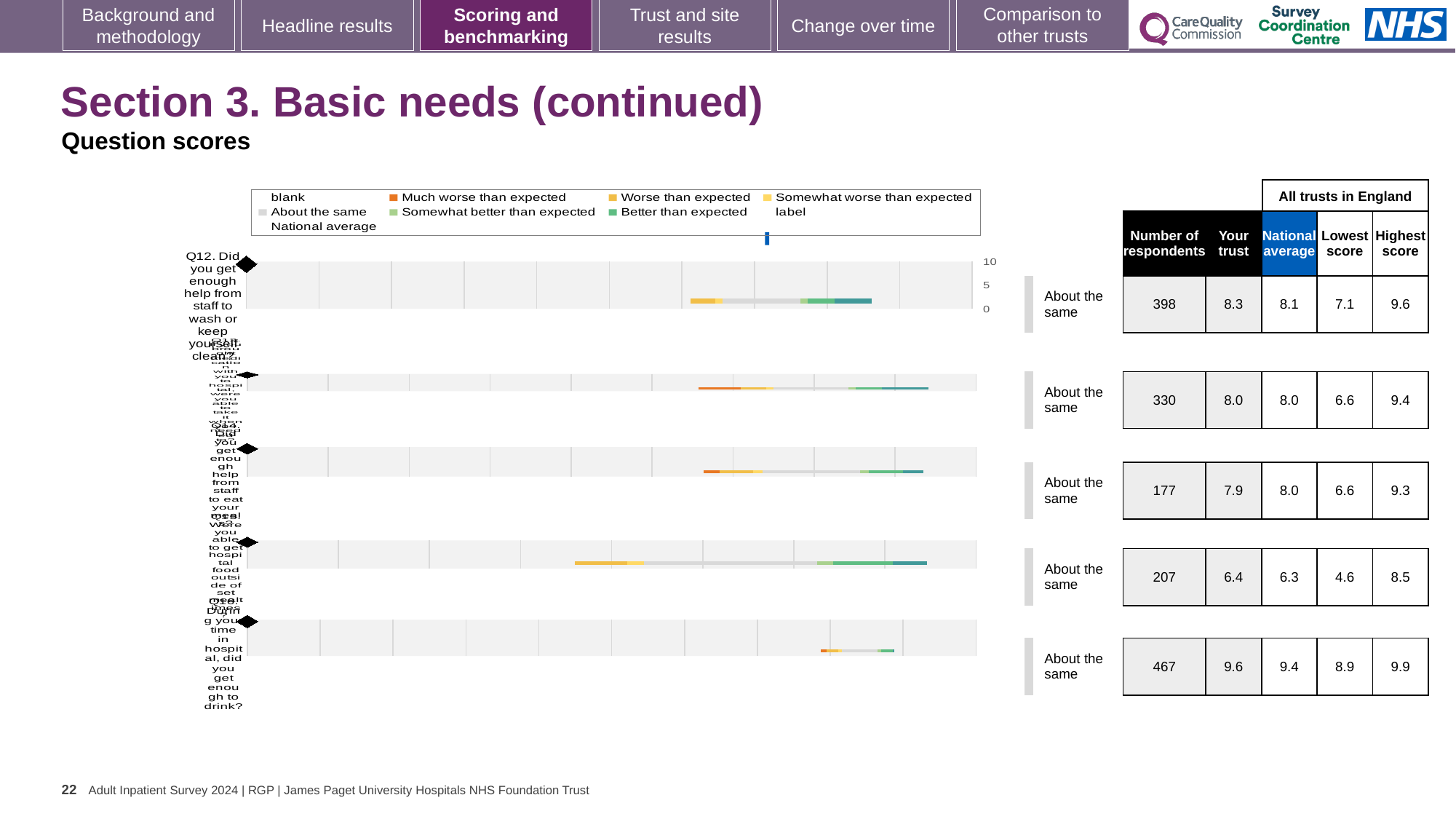
What is the lowest score among all trusts in England for the fifth (bottom) row? 8.9 What is the 'Your trust' score for Q12 (the first row, about getting enough help from staff to wash or keep yourself clean)? 8.3 How many respondents are listed for the first row (Q12)? 398 What is the highest score among all trusts in England for the fourth row? 8.5 What benchmark category is shown next to every row of the chart? About the same For the first row (Q12), which is larger: the 'Your trust' score or the national average? Your trust For the first row (Q12), how much higher is the 'Your trust' score than the national average? 0.2 What kind of chart is used to show the question scores on this slide? bar chart How many question rows are plotted in the chart? 5 Which row has the lowest 'Your trust' score? the fourth row, 6.4 For the fourth row, what is the difference between the highest score and the lowest score among all trusts in England? 3.9 Which row has the highest 'Your trust' score? the fifth (bottom) row, 9.6